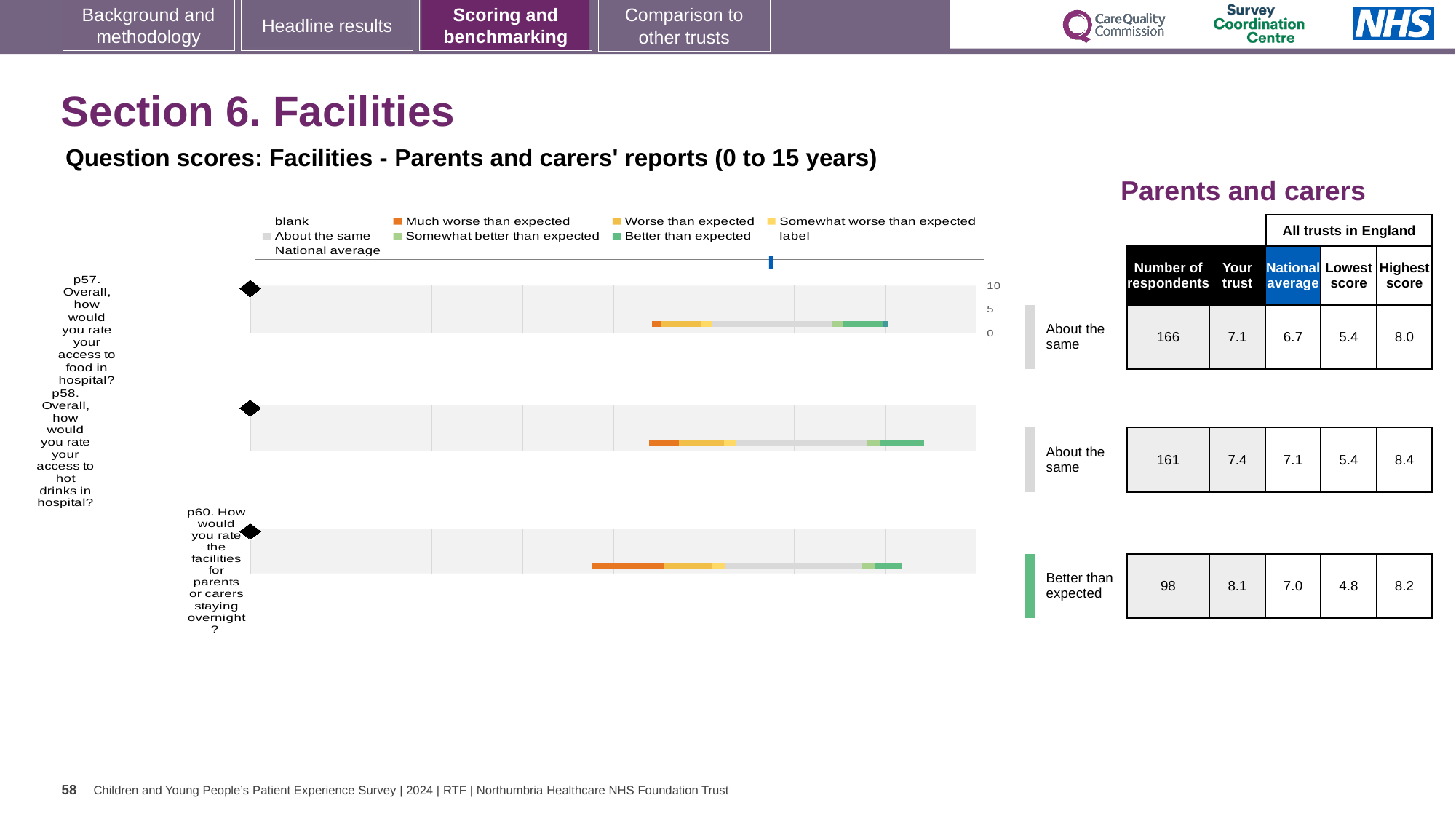
How many respondents answered p60 (facilities for parents or carers staying overnight)? 98 What is the national average score for p58 (access to hot drinks in hospital)? 7.1 What is the difference between the 'Your trust' score and the national average for p60? 1.1 What is the lowest score among all trusts in England for p60? 4.8 How many questions (rows) are plotted in the chart? 3 For p57, which is larger: the 'Your trust' score or the national average? Your trust What benchmark category is shown for p60? Better than expected What is the highest score among all trusts in England for p58? 8.4 What is the 'Your trust' score for p57 (access to food in hospital)? 7.1 Which question has the highest 'Your trust' score? p60 Which question has the lowest national average score? p57 What kind of chart is used to show the question scores on this slide? bar chart